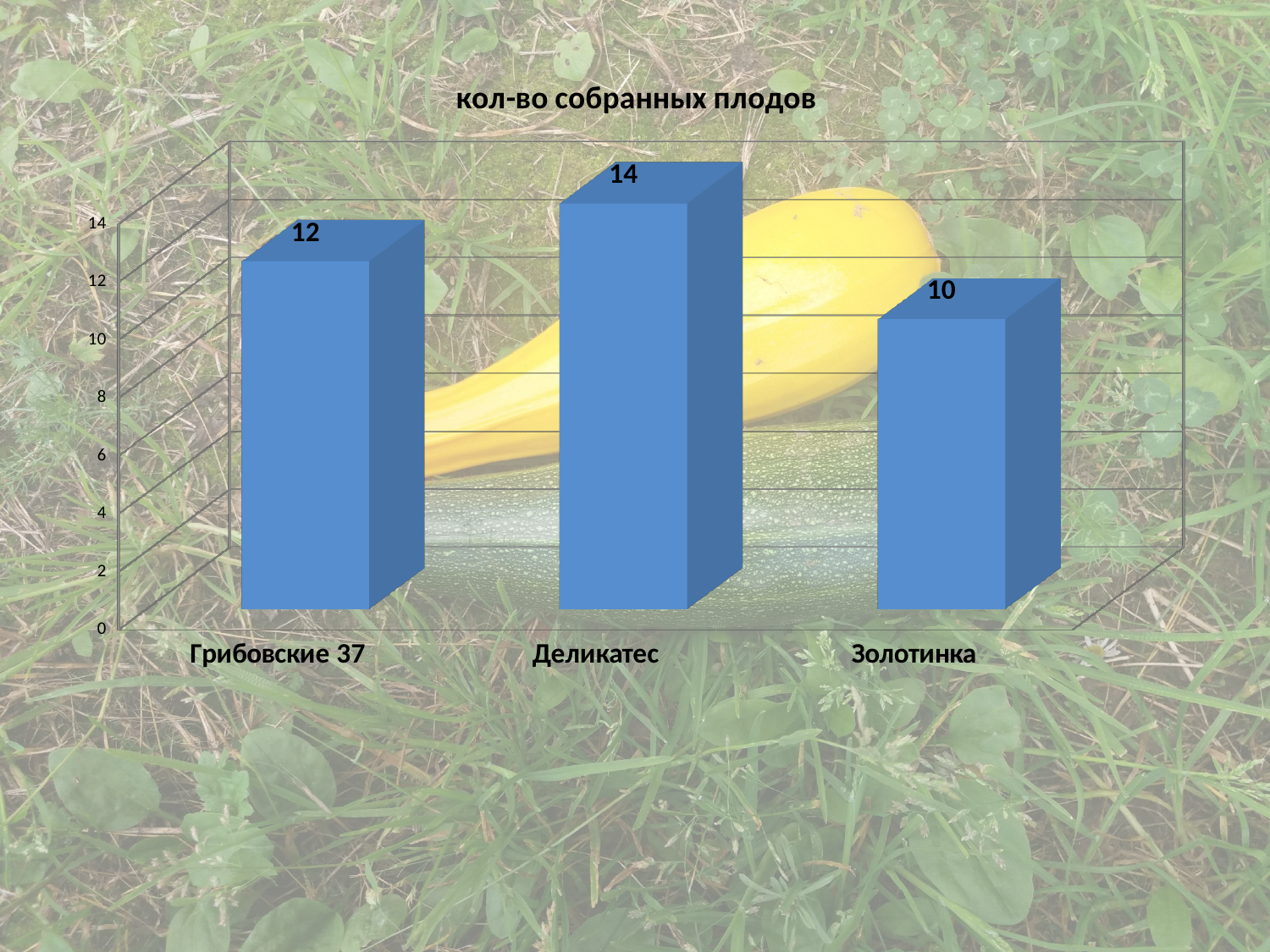
What is the value for Грибовские 37? 12 What is the value for Золотинка? 10 Which is larger, the value for Грибовские 37 or the value for Деликатес? Деликатес What is the value for Деликатес? 14 What is the difference between the values for Деликатес and Золотинка? 4 What kind of chart is shown on the slide? bar chart What is the title of the chart? кол-во собранных плодов Which category has the highest value? Деликатес How many categories are shown in the chart? 3 What is the difference between the values for Грибовские 37 and Золотинка? 2 Is the value for Золотинка greater or less than 12? less Which category has the lowest value? Золотинка